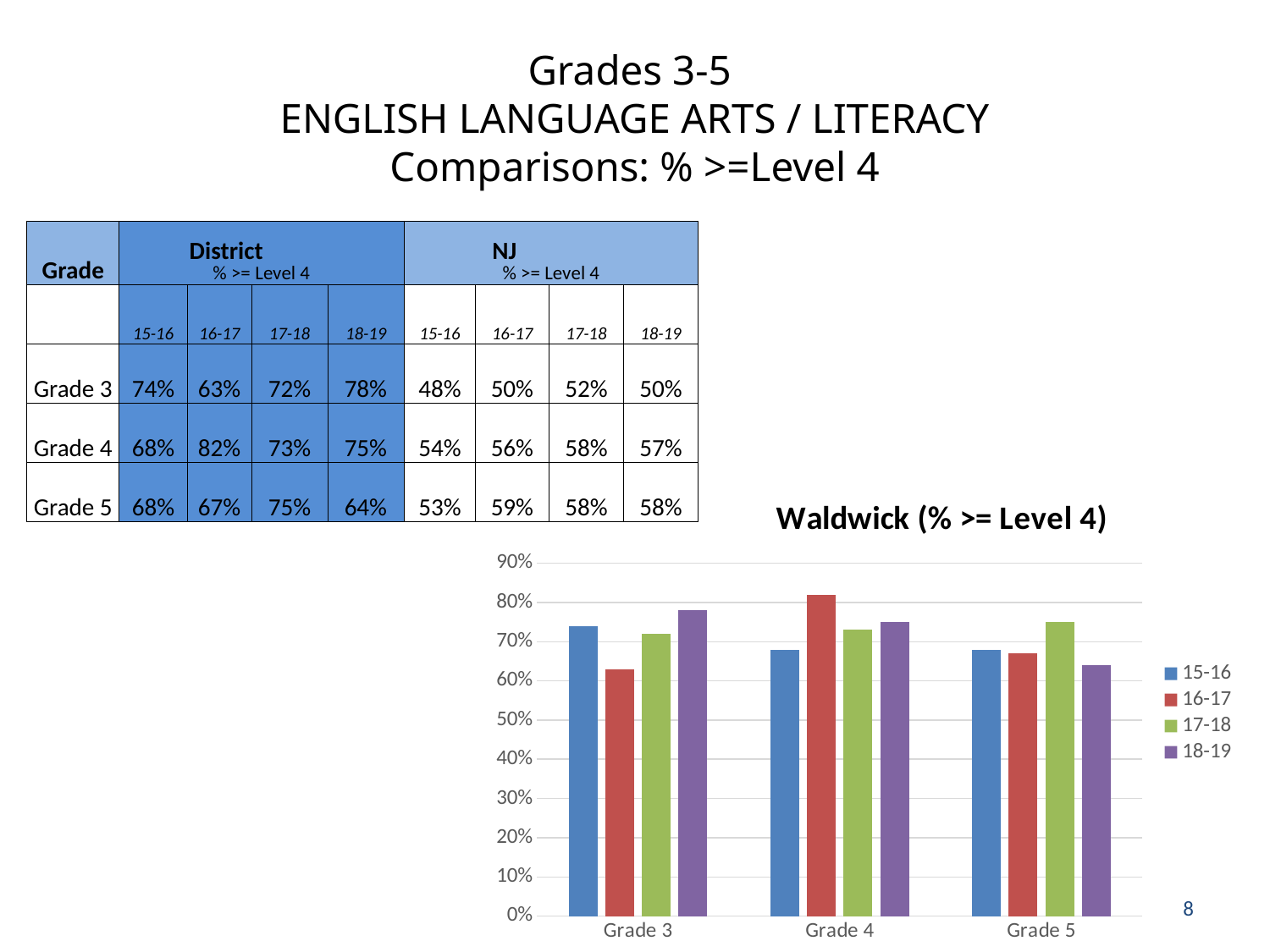
In the Waldwick (% >= Level 4) chart, which grade has the highest 16-17 bar? Grade 4 In the Waldwick (% >= Level 4) chart, which is larger for Grade 3: the 15-16 bar or the 16-17 bar? 15-16 In the Waldwick (% >= Level 4) chart, is the 16-17 value for Grade 3 greater or less than 70%? less In the Waldwick (% >= Level 4) chart, is the 16-17 value for Grade 4 greater or less than 80%? greater In the Waldwick (% >= Level 4) chart, which is larger for Grade 5: the 17-18 bar or the 18-19 bar? 17-18 In the Waldwick (% >= Level 4) chart, which grade has the lowest 18-19 bar? Grade 5 What is the title of the chart on the slide? Waldwick (% >= Level 4) What is the value for Grade 3 in 18-19 in the Waldwick (% >= Level 4) chart, as printed in the District table? 78% What is the value for Grade 4 in 16-17 in the Waldwick (% >= Level 4) chart, as printed in the District table? 82% How many grade categories are shown on the x axis of the Waldwick (% >= Level 4) chart? 3 What kind of chart is the Waldwick (% >= Level 4) chart? bar chart How many series does the legend of the Waldwick (% >= Level 4) chart list? 4